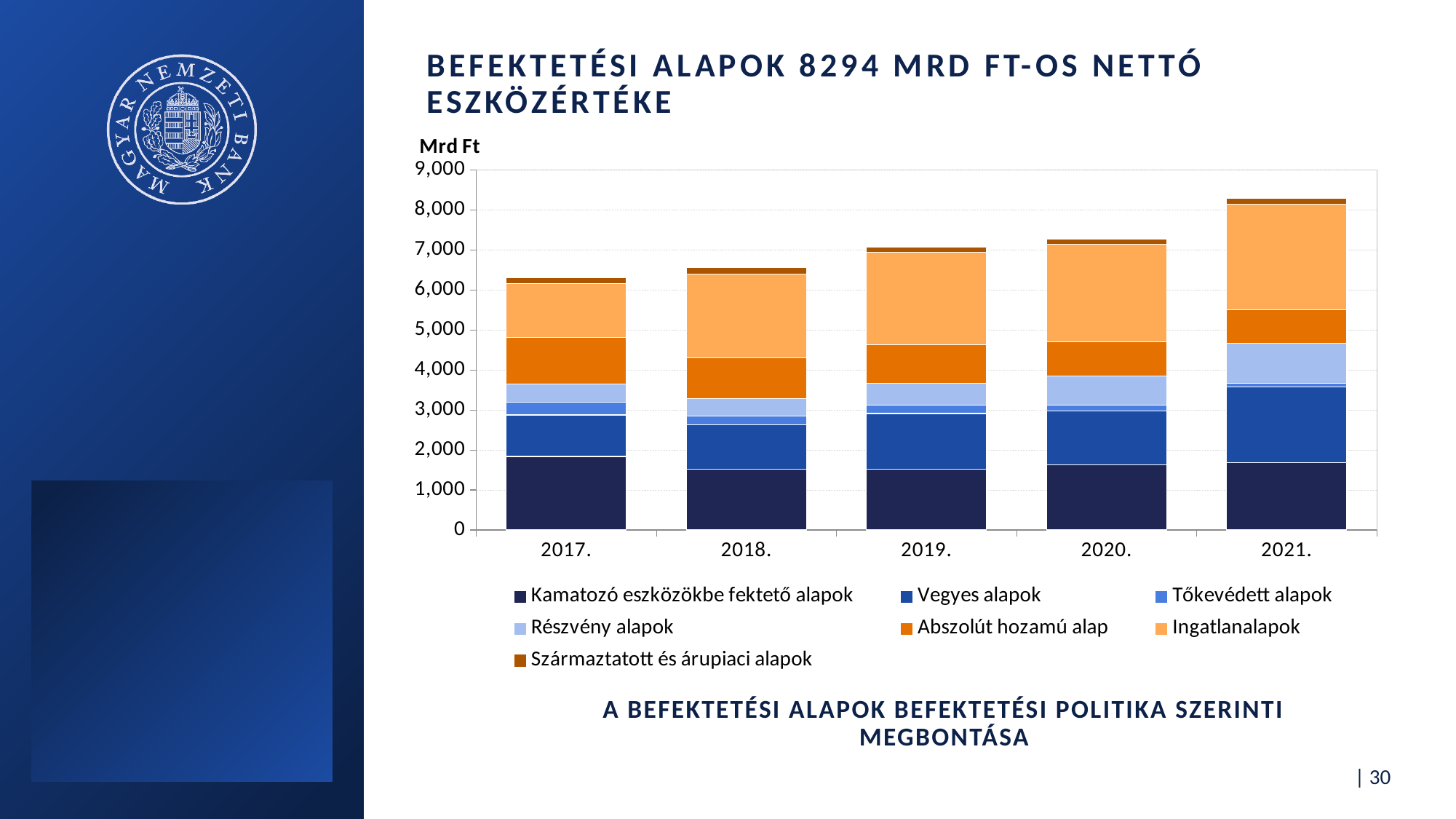
What kind of chart is shown on the slide? stacked bar chart What unit is shown above the vertical axis of the chart? Mrd Ft Do the total heights of the stacked bars rise or fall from 2017 to 2021? rise Is the total of the stacked bar for 2017 greater or less than 7,000? less Is the Kamatozó eszközökbe fektető alapok segment for 2017 greater or less than 1,000? greater Is the total of the stacked bar for 2020 greater or less than 7,000? greater How many series does the chart legend list? 7 Is the Ingatlanalapok segment larger in 2021 or in 2017? 2021 Which legend entry is shown in the darkest blue colour at the bottom of each bar? Kamatozó eszközökbe fektető alapok How many years are shown on the x axis of the chart? 5 Which year has the tallest stacked bar? 2021.